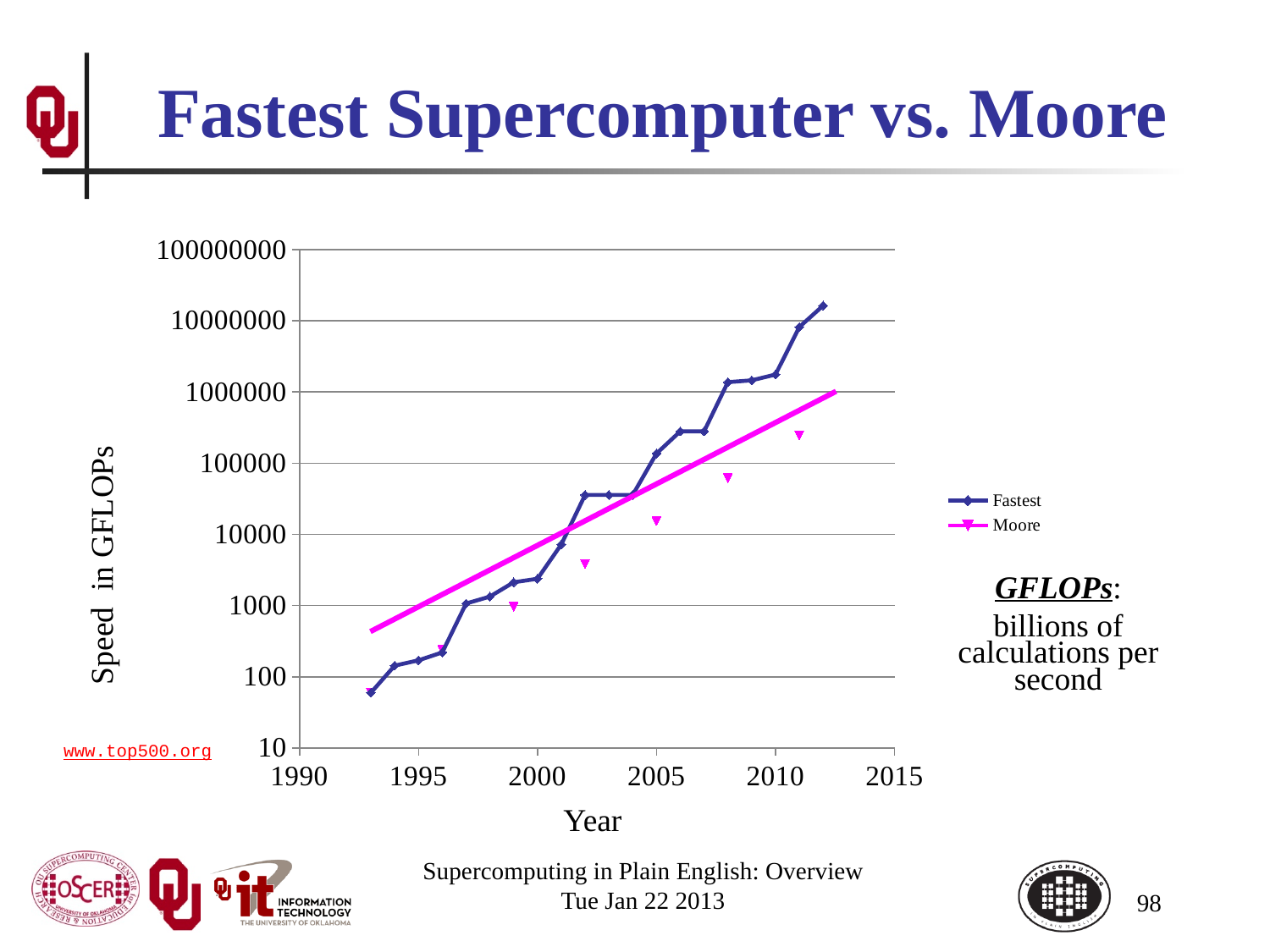
In 2011, which series has the higher value, Fastest or Moore? Fastest Is the Moore value for 2011 greater or less than 100000? greater Is the Fastest value for 2012 greater or less than 10000000? greater In which year does the Fastest series reach its highest value? 2012 Does the Fastest series rise or fall as the year increases? rise What is the title of the chart? Fastest Supercomputer vs. Moore What are the two series named in the legend? Fastest and Moore What kind of chart is shown on the slide? line chart Is the Fastest value for 2002 greater or less than 100000? less How many series does the legend list? 2 In 2005, which series has the higher value, Fastest or Moore? Fastest